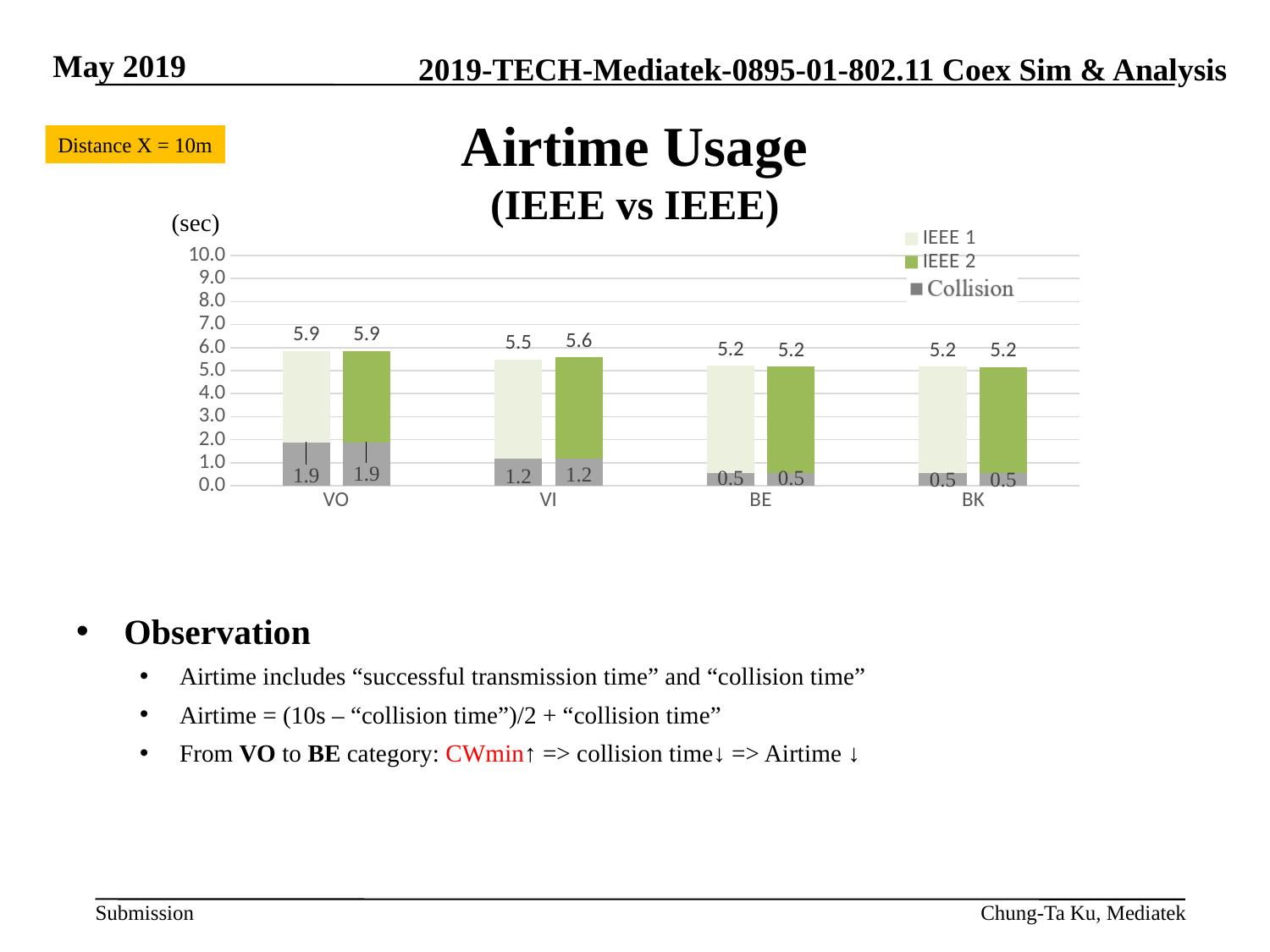
What is the IEEE 1 airtime value for the VO category? 5.9 What is the collision time shown for IEEE 2 in the BK category? 0.5 Is the IEEE 2 airtime for VI larger or smaller than the IEEE 2 airtime for BE? larger How many series does the chart legend list? 3 What unit is shown on the y axis of the chart? sec What is the difference between the IEEE 1 airtime for VO and the IEEE 1 airtime for VI? 0.4 What type of chart is shown on the slide? bar chart How many categories are shown on the x axis of the chart? 4 Which category has the highest IEEE 1 airtime value? VO What is the IEEE 2 airtime value for the VI category? 5.6 What is the collision time shown for IEEE 1 in the VO category? 1.9 What is the IEEE 1 airtime value for the BE category? 5.2